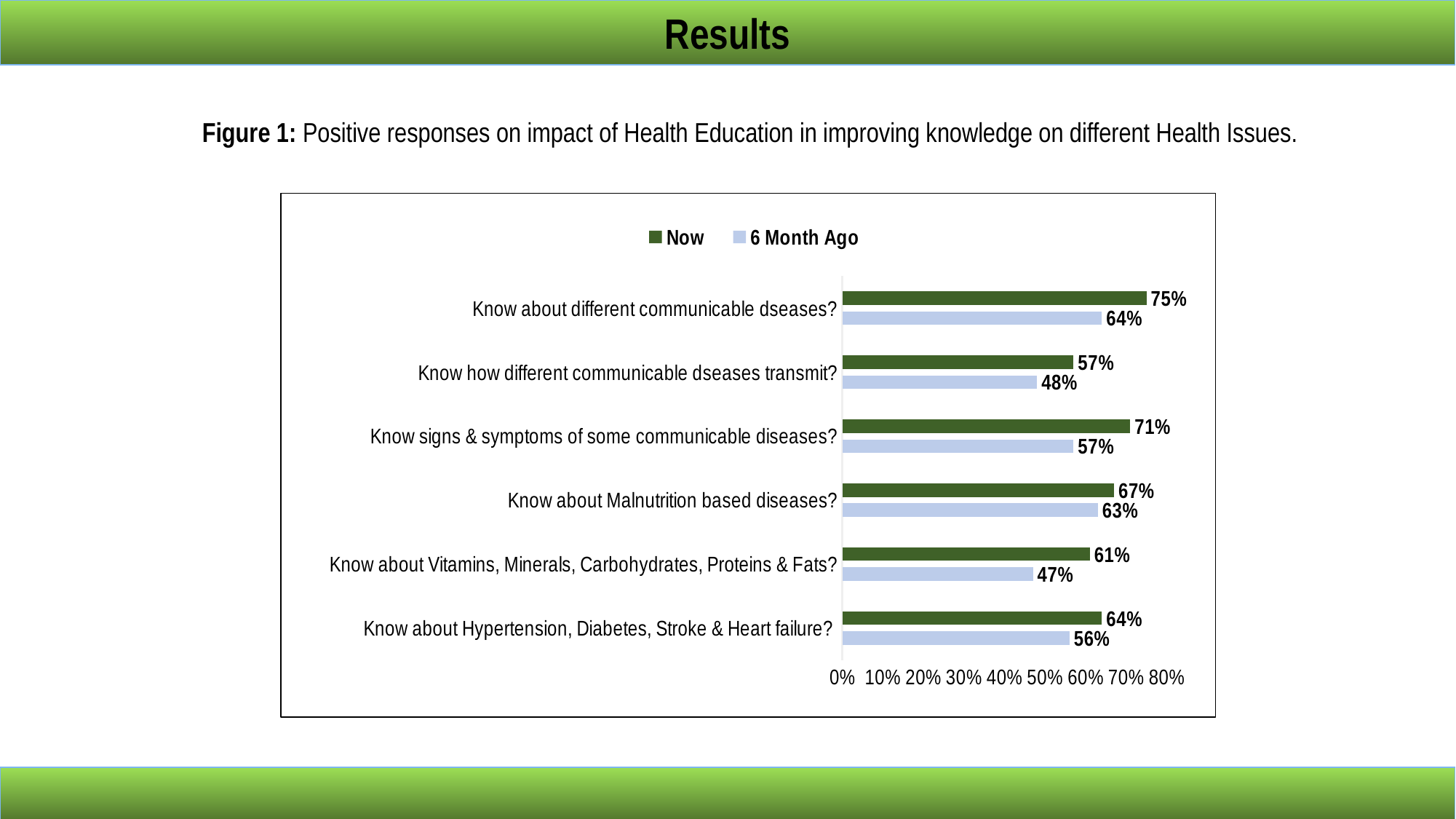
What is the 'Now' value for 'Know how different communicable dseases transmit?' 57% Which is larger for 'Know about Malnutrition based diseases?': the 'Now' value or the '6 Month Ago' value? Now Which category has the lowest '6 Month Ago' value? Know about Vitamins, Minerals, Carbohydrates, Proteins & Fats? What is the difference between the 'Now' and '6 Month Ago' values for 'Know signs & symptoms of some communicable diseases?' 14% What is the '6 Month Ago' value for 'Know about Hypertension, Diabetes, Stroke & Heart failure?' 56% What kind of chart is shown on the slide? Bar chart How many series does the legend list? 2 What is the 'Now' value for 'Know about different communicable dseases?' 75% How many categories are shown on the chart? 6 What is the '6 Month Ago' value for 'Know about Vitamins, Minerals, Carbohydrates, Proteins & Fats?' 47% What are the two series named in the legend? Now and 6 Month Ago Which category has the highest 'Now' value? Know about different communicable dseases?